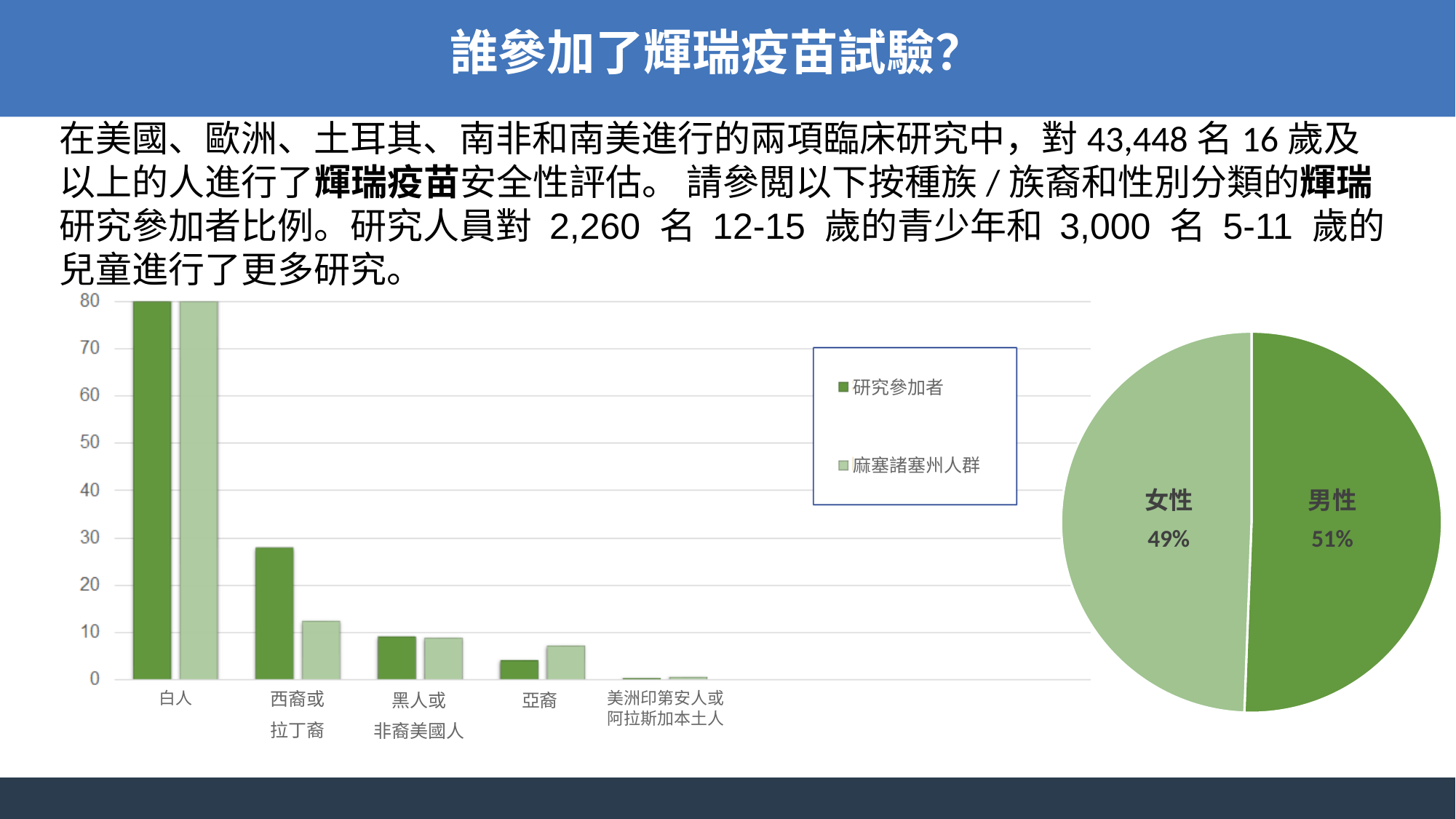
In the bar chart on the left, which category has the lowest value for 研究參加者? 美洲印第安人或阿拉斯加本土人 In the pie chart on the right, what is the difference between the 男性 and 女性 shares? 2% In the bar chart on the left, for 亞裔, which series has the larger value, 研究參加者 or 麻塞諸塞州人群? 麻塞諸塞州人群 In the pie chart on the right, what share is labelled for 男性? 51% In the pie chart on the right, what share is labelled for 女性? 49% In the bar chart on the left, what are the two series named in the legend? 研究參加者 and 麻塞諸塞州人群 In the pie chart on the right, which slice is larger, 女性 or 男性? 男性 In the bar chart on the left, is the 研究參加者 value for 西裔或拉丁裔 greater or less than 20? greater In the bar chart on the left, which category has the highest value for 研究參加者? 白人 What kind of chart is the chart on the left of the slide? bar chart How many series does the legend of the bar chart on the left list? 2 How many categories are shown on the x axis of the bar chart on the left? 5